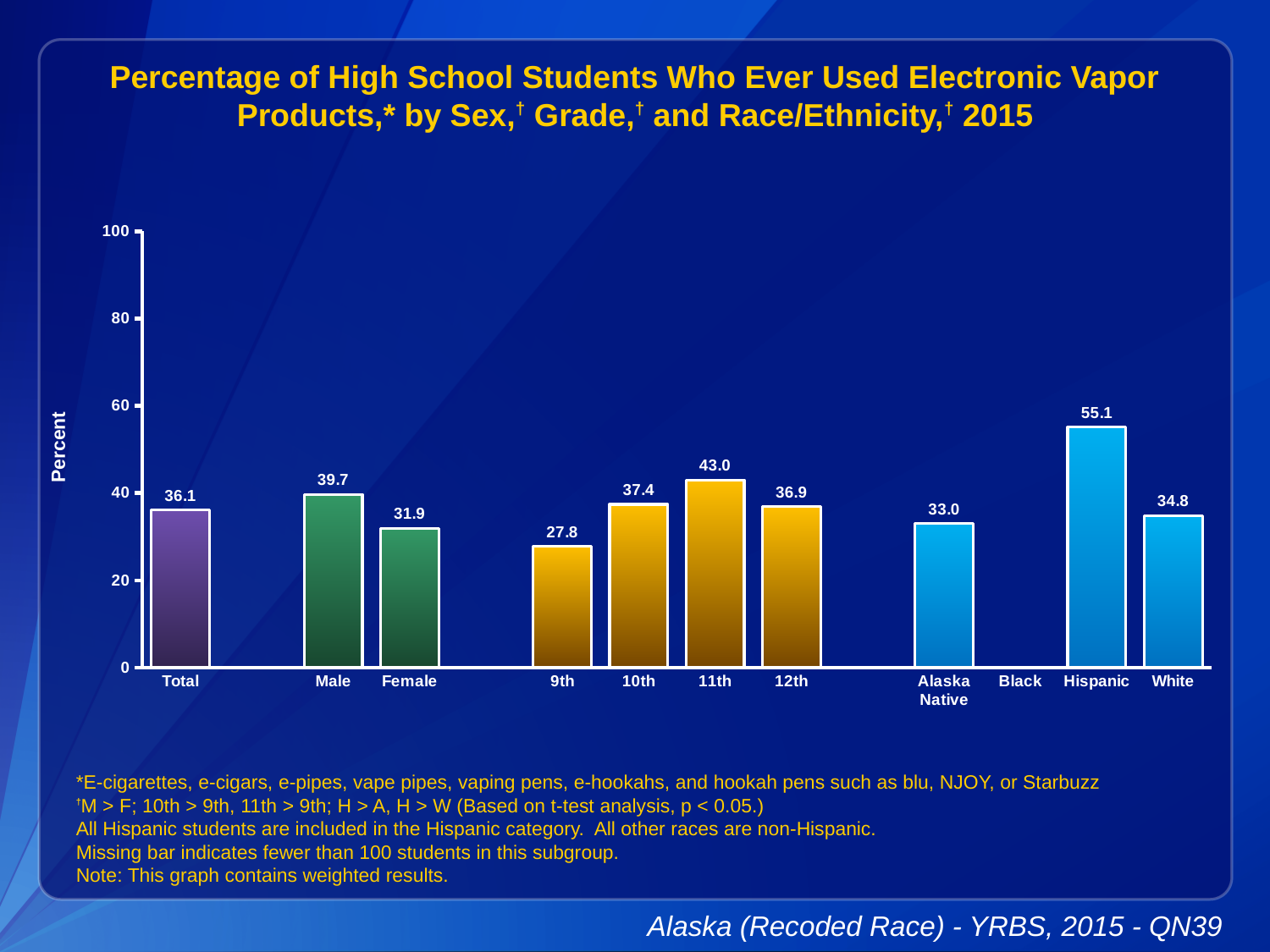
What kind of chart is this? bar chart What is the value for Total? 36.1 What is the value for Alaska Native? 33.0 What is the difference between the Male and Female values? 7.8 How many categories have a bar plotted? 10 What is the value for Male? 39.7 Is the value for Hispanic greater or less than 60? less Which is larger, the value for 10th grade or 12th grade? 10th Which category label has no bar shown? Black Which category has the lowest value? 9th What is the value for 11th grade? 43.0 Which category has the highest value? Hispanic